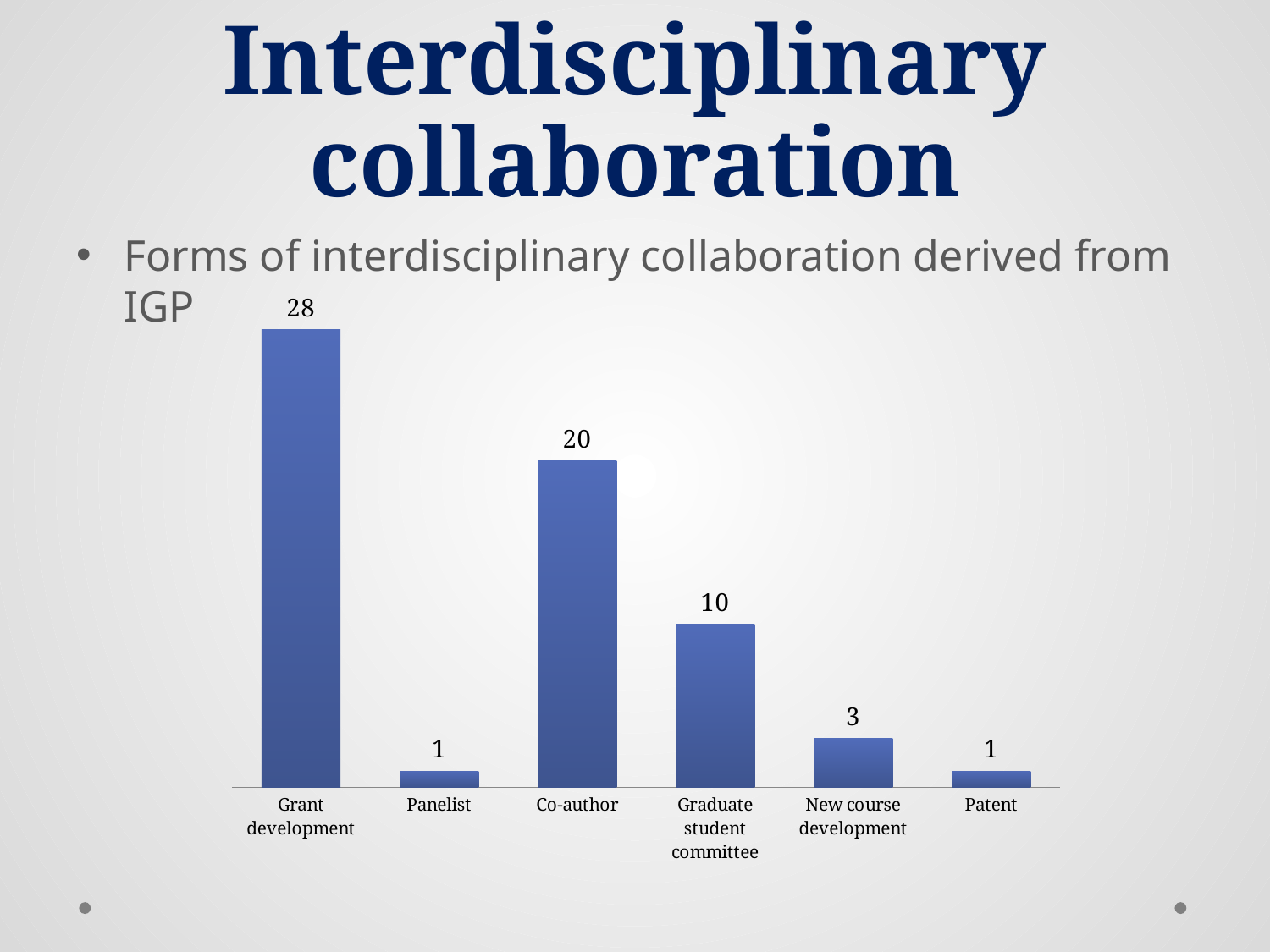
What kind of chart is shown on the slide? Bar chart What is the total of the values for Panelist and Patent? 2 What is the difference between the values for Grant development and Co-author? 8 What is the value for Co-author? 20 What is the value for New course development? 3 What is the value for Grant development? 28 Which category has the highest value? Grant development Which is larger, the value for Graduate student committee or the value for New course development? Graduate student committee How many categories are shown on the x axis? 6 What is the value for Graduate student committee? 10 What is the difference between the values for Co-author and Graduate student committee? 10 Which two categories share the lowest value of 1? Panelist and Patent